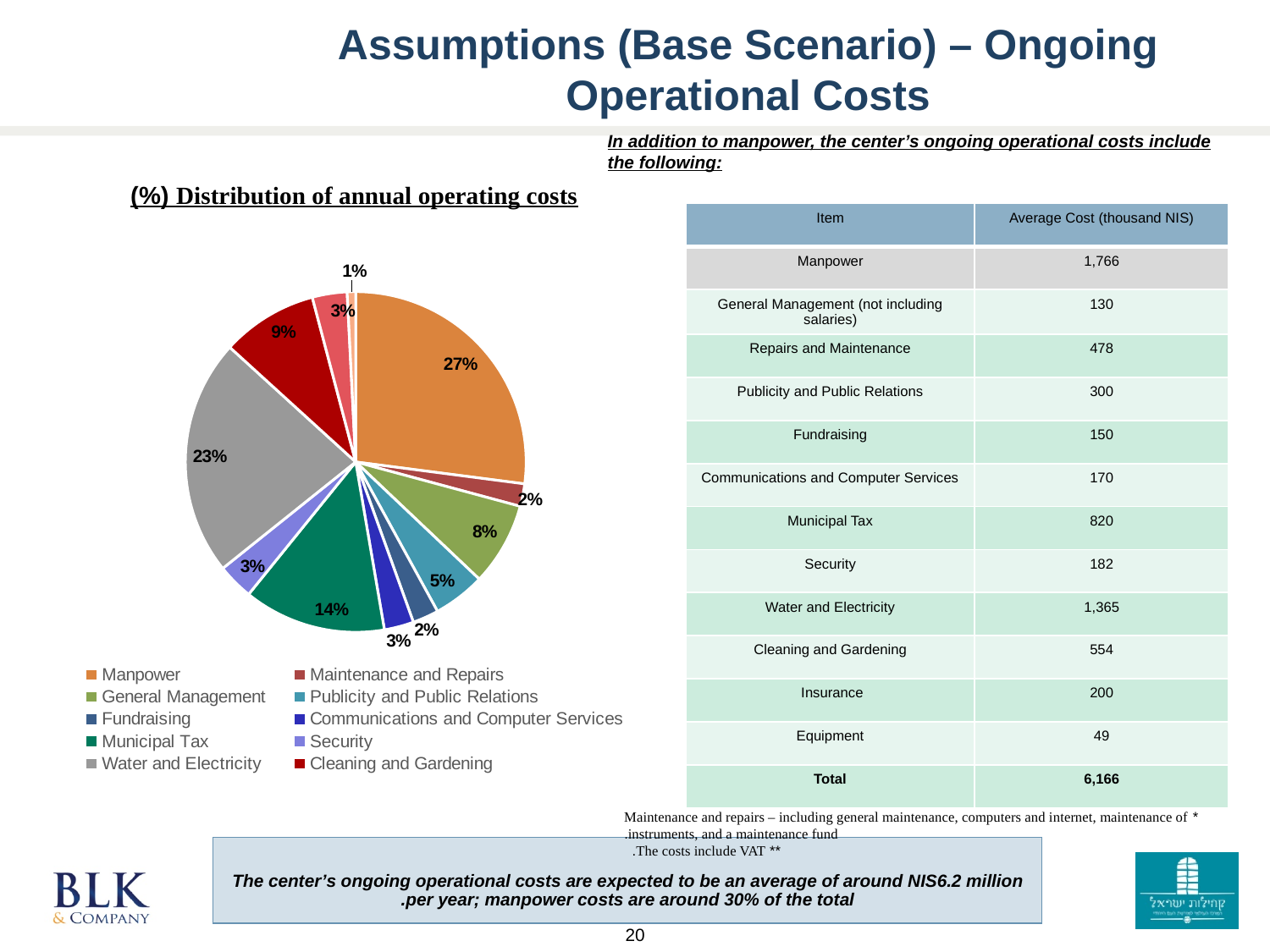
What percentage does Water and Electricity represent in the pie chart? 23% What is the title of the pie chart? (%) Distribution of annual operating costs What percentage is shown for Publicity and Public Relations in the pie chart? 5% Which is larger in the pie chart, Municipal Tax or Cleaning and Gardening? Municipal Tax What kind of chart is shown on the slide? Pie chart How many entries does the pie chart's legend list? 10 What is the smallest percentage labelled on the pie chart? 1% What share of the pie chart is Municipal Tax? 14% By how many percentage points does Manpower exceed Water and Electricity in the pie chart? 4 percentage points Which category has the largest slice in the pie chart? Manpower What percentage is shown for Cleaning and Gardening in the pie chart? 9% What percentage of annual operating costs does Manpower account for in the pie chart? 27%